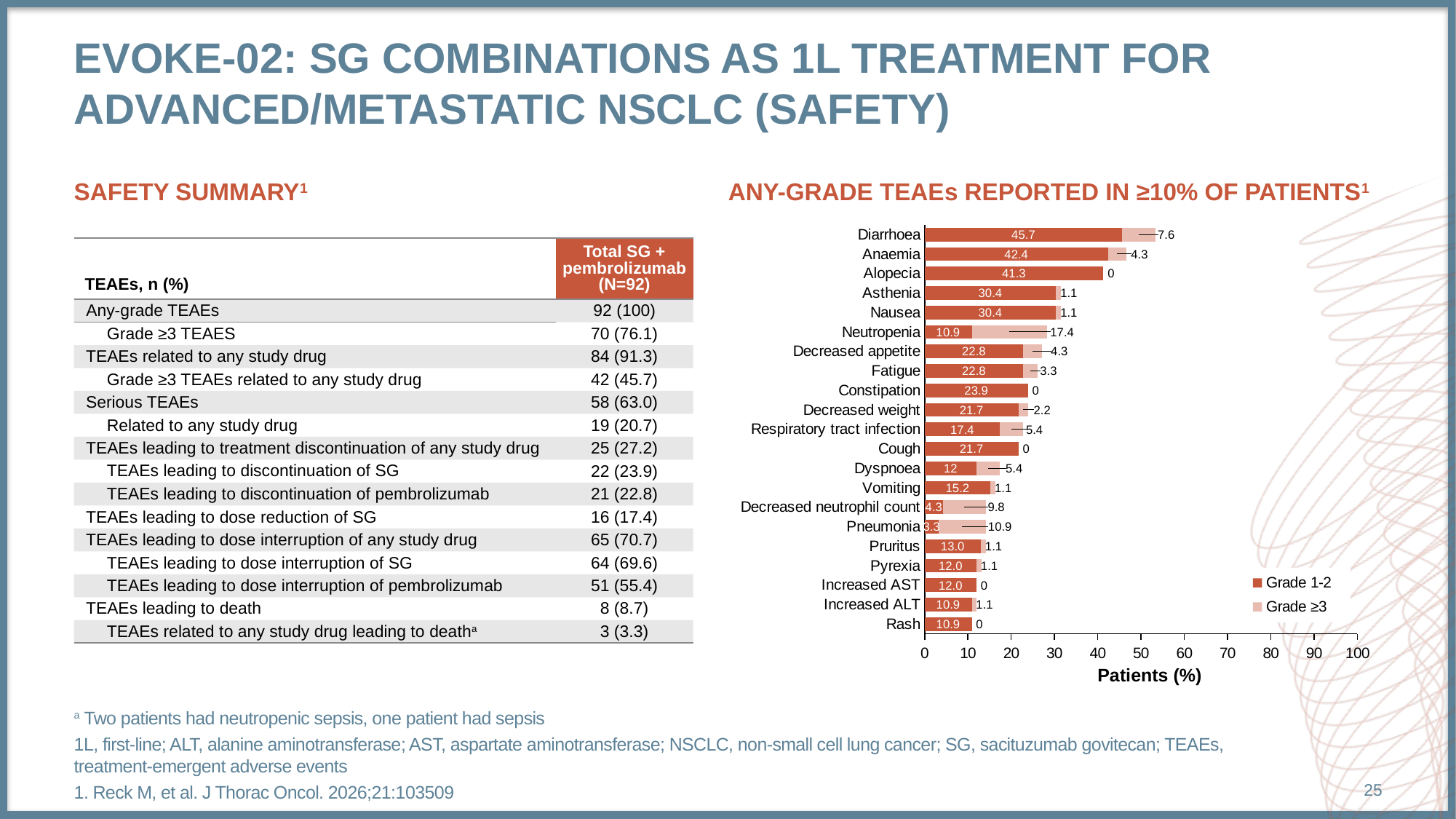
Which category has the highest Grade ≥3 value? Neutropenia Which category has the lowest Grade 1-2 value? Pneumonia How many TEAE categories are plotted in the chart? 21 What is the Grade ≥3 value for Neutropenia? 17.4 What kind of chart is shown on the slide? Bar chart What is the difference between the Grade 1-2 values for Diarrhoea and Anaemia? 3.3 Which category has the highest Grade 1-2 value? Diarrhoea What is the total (Grade 1-2 plus Grade ≥3) for Diarrhoea? 53.3 What is the Grade ≥3 value for Alopecia? 0 Which is larger, the Grade 1-2 value for Constipation or for Fatigue? Constipation How many series does the chart legend list? 2 What is the Grade 1-2 value for Diarrhoea? 45.7